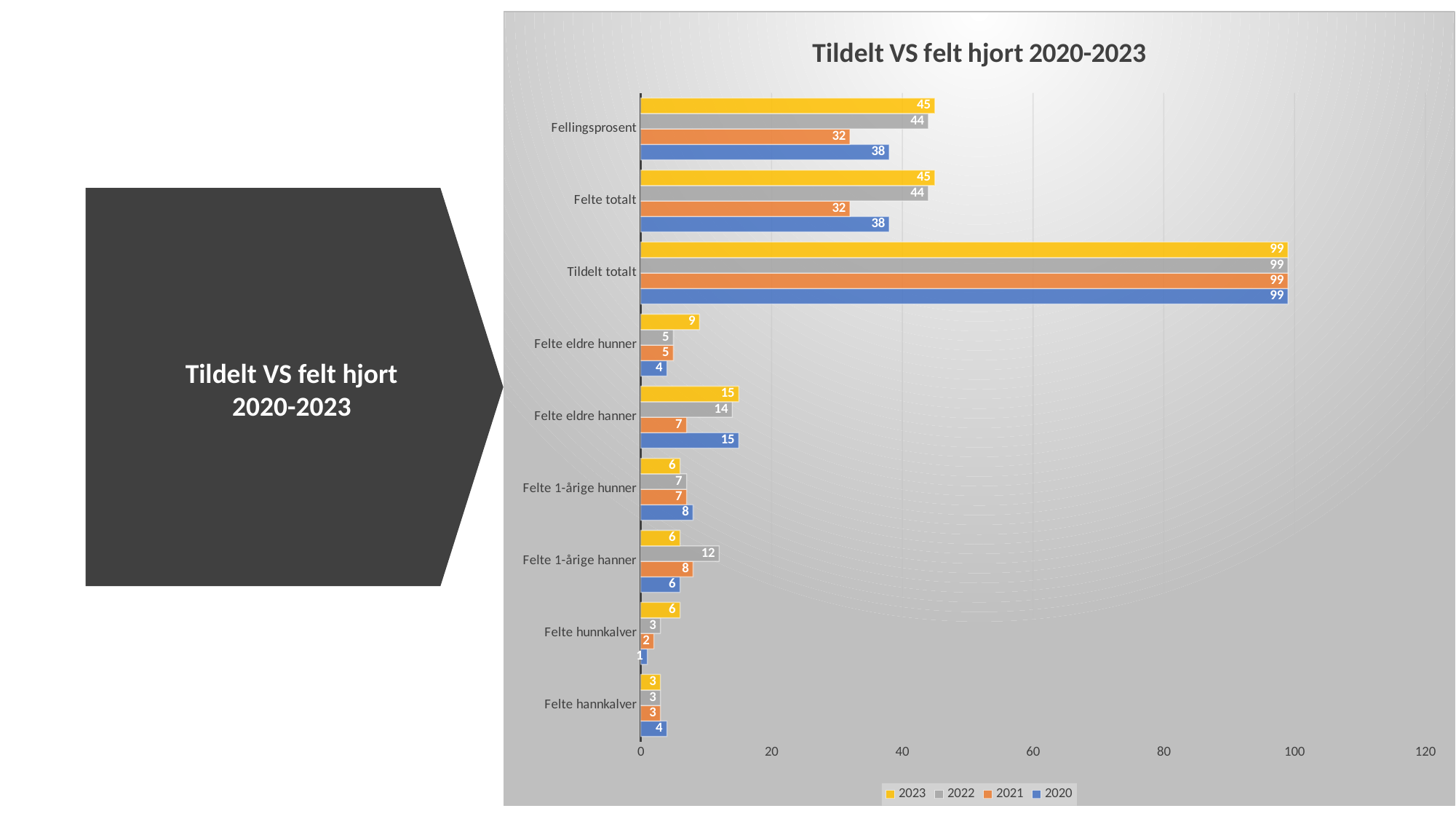
What is the value for Felte 1-årige hanner in 2022? 12 How many categories are shown on the y axis? 9 Which year has the highest value for Felte eldre hunner? 2023 What is the value for Felte hunnkalver in 2020? 1 What is the title of the chart? Tildelt VS felt hjort 2020-2023 Which is larger for Felte 1-årige hunner: the 2020 value or the 2023 value? 2020 How many series does the legend list? 4 What is the value for Felte totalt in 2023? 45 Which year has the lowest value for Fellingsprosent? 2021 What is the difference between the 2023 and 2021 values for Felte totalt? 13 What is the value for Felte eldre hanner in 2021? 7 What kind of chart is shown on the slide? bar chart